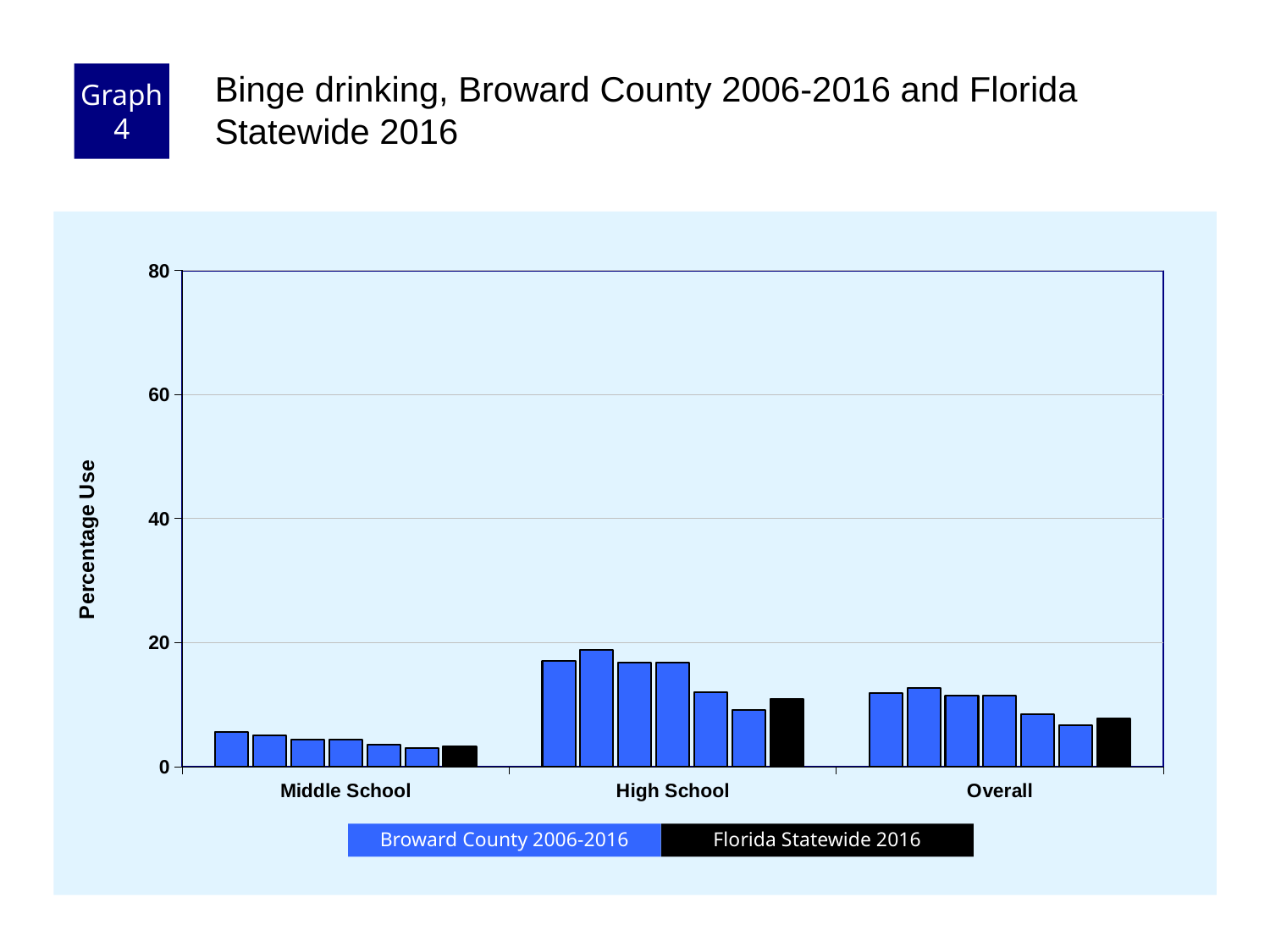
Do the Broward County 2006-2016 bars for High School rise or fall over time? fall Is the Florida Statewide 2016 value for High School greater or less than 20? less Do the Broward County 2006-2016 bars for Middle School rise or fall over time? fall How many school-level categories are shown on the x axis? 3 Is the Florida Statewide 2016 value for Overall greater or less than 20? less What is the label on the y axis? Percentage Use Are the Middle School values for Broward County 2006-2016 greater or less than 20? less Which category has the lowest binge drinking percentages? Middle School How many series does the legend list? 2 Which category has the highest binge drinking percentages? High School What kind of chart is shown on the slide? bar chart Which is larger, the Florida Statewide 2016 value for High School or for Middle School? High School